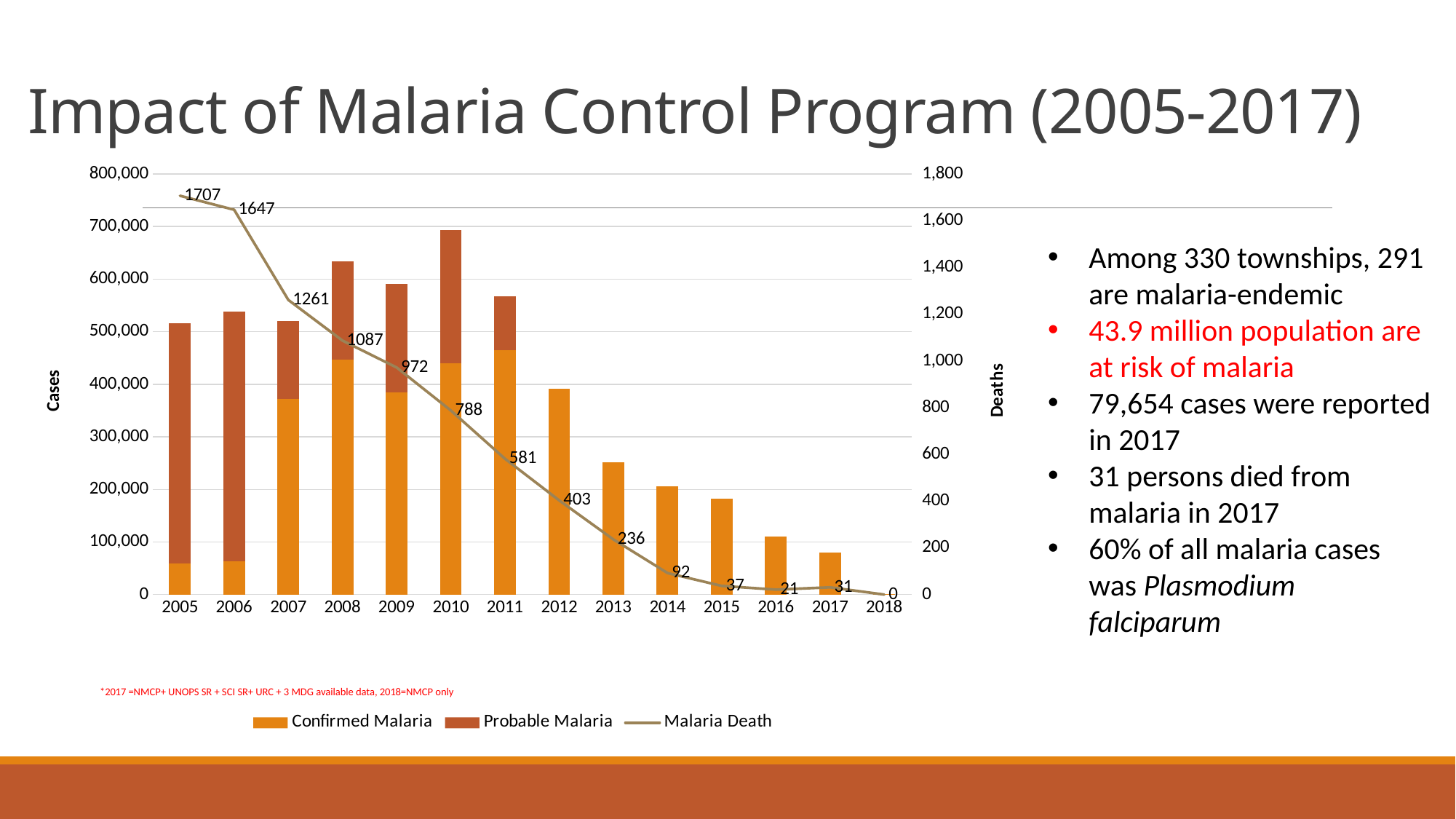
Is the total number of cases (Confirmed plus Probable Malaria) for 2010 greater or less than 600,000? greater How many years are shown on the x axis of the chart? 14 In which year is the Malaria Death value lowest? 2018 How many series does the chart legend list? 3 Is the total number of cases for 2017 greater or less than 100,000? less Which year has the larger Malaria Death value, 2016 or 2017? 2017 What is the Malaria Death value for 2012? 403 What kind of chart is shown on the slide? A stacked bar chart combined with a line chart In which year is the Malaria Death value highest? 2005 What is the Malaria Death value for 2005? 1707 What is the difference between the Malaria Death values for 2005 and 2006? 60 Does the Malaria Death line generally rise or fall from 2005 to 2018? fall